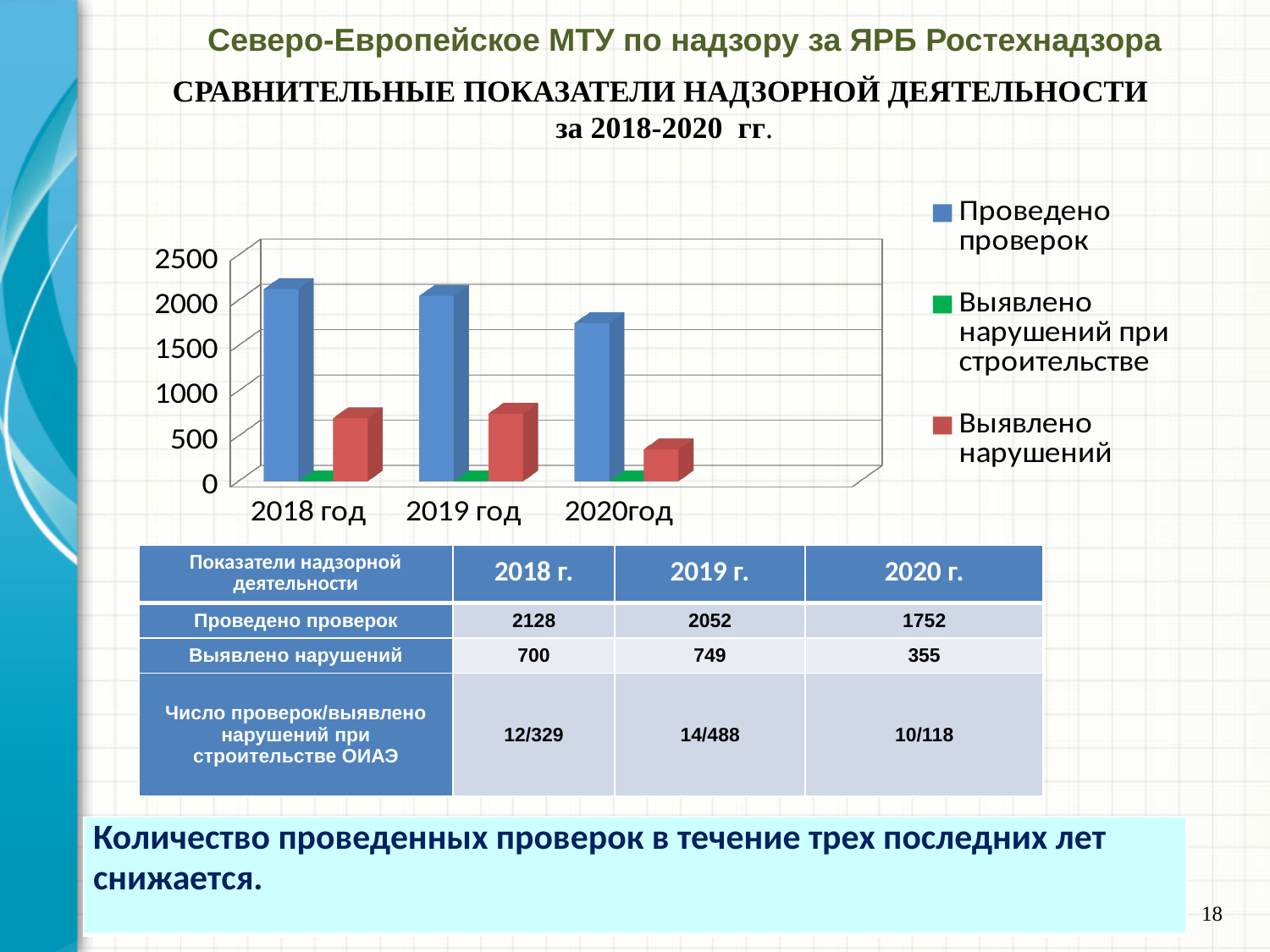
Is the value for 'Выявлено нарушений' in 2020 год greater or less than 500? less How many year categories are shown on the x axis of the chart? 3 What is the difference between 'Проведено проверок' in 2018 and in 2020? 376 What kind of chart is shown on the slide? bar chart Which year has the lowest value for 'Выявлено нарушений'? 2020 год What is the value of 'Выявлено нарушений' for 2019 год? 749 How many series does the chart legend list? 3 Does the 'Проведено проверок' series rise or fall from 2018 to 2020? fall Which colour represents 'Проведено проверок' in the chart legend? blue What is the value of 'Проведено проверок' for 2020 год? 1752 Which year has the highest value for 'Проведено проверок'? 2018 год What is the value of 'Проведено проверок' for 2018 год? 2128